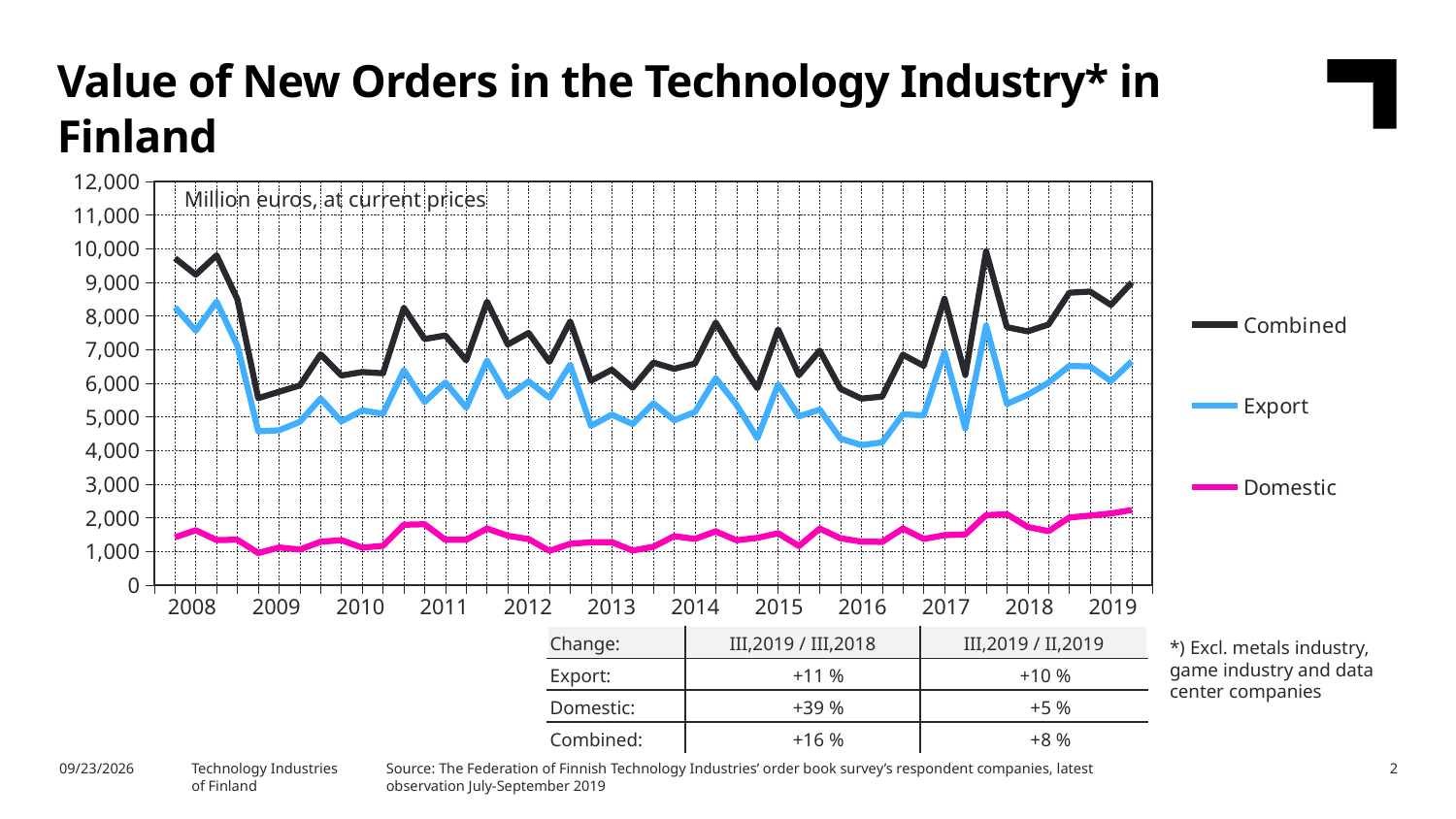
What kind of chart is shown on the slide? line chart Is the Combined value at the start of 2008 greater or less than 9,000? greater Does the Combined series rise or fall from the start of 2008 to the start of 2009? fall Which is larger at the last point in 2019, the Combined value or the Export value? Combined Is the Combined peak in 2017 greater or less than 9,000? greater Is the Export value at the last point in 2019 greater or less than 6,000? greater How many series does the legend list? 3 Which series has the highest values across the whole period? Combined Which series has the lowest values across the whole period? Domestic What unit label is shown inside the chart area? Million euros, at current prices